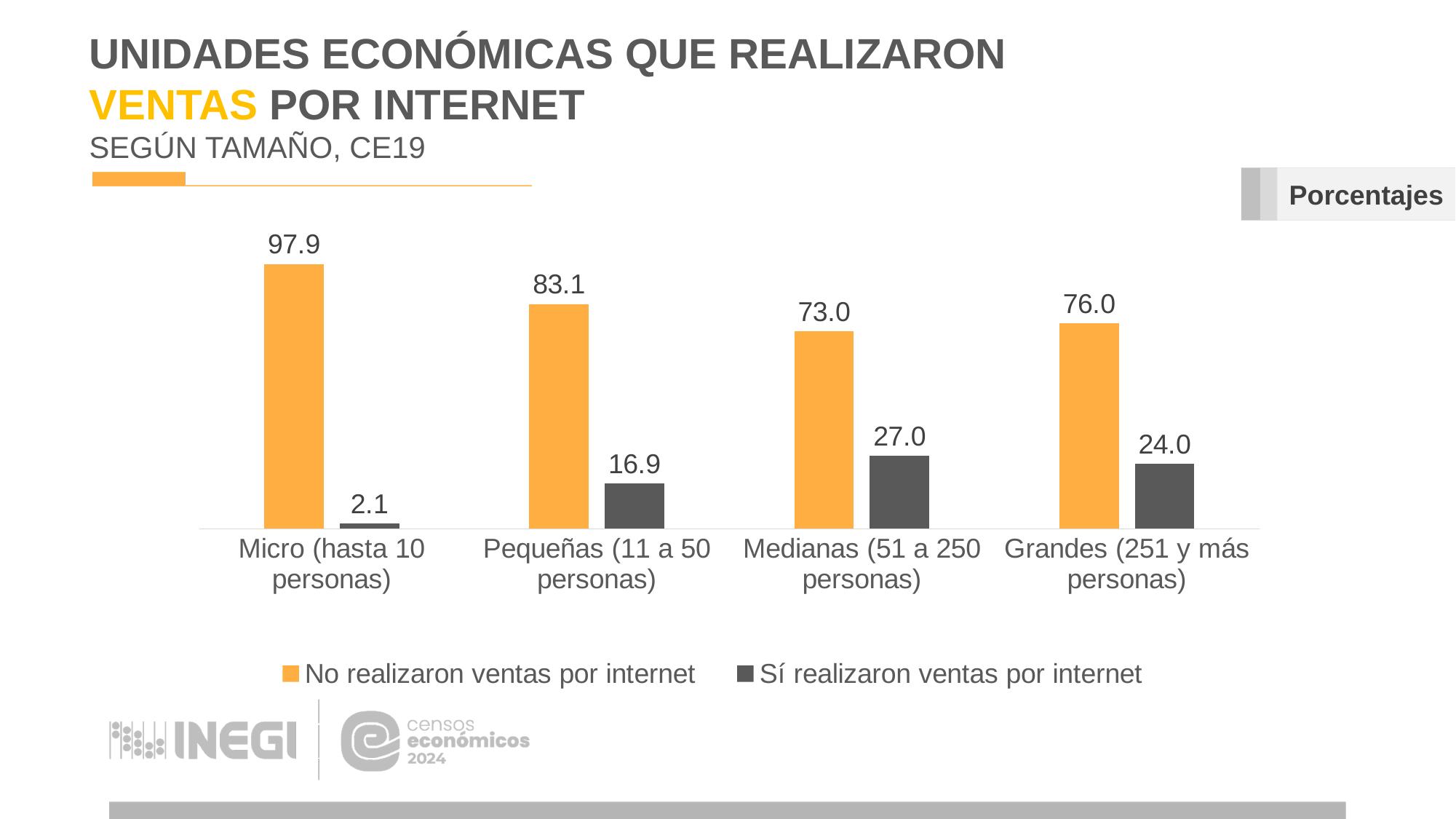
Which size category has the lowest value for 'No realizaron ventas por internet'? Medianas (51 a 250 personas) Which colour represents 'Sí realizaron ventas por internet' in the legend? Dark grey How many size categories are shown on the x axis? 4 What kind of chart is shown on the slide? Bar chart Which size category has the highest value for 'Sí realizaron ventas por internet'? Medianas (51 a 250 personas) What is the value for 'Sí realizaron ventas por internet' for Pequeñas (11 a 50 personas)? 16.9 What is the value for 'Sí realizaron ventas por internet' for Medianas (51 a 250 personas)? 27.0 Do the 'No realizaron ventas por internet' values rise or fall from Micro to Medianas along the x axis? Fall How many series does the legend list? 2 What is the difference between the 'No realizaron ventas por internet' values for Micro (hasta 10 personas) and Grandes (251 y más personas)? 21.9 Which is larger: the 'Sí realizaron ventas por internet' value for Grandes (251 y más personas) or for Pequeñas (11 a 50 personas)? Grandes (251 y más personas) What is the value for 'No realizaron ventas por internet' for Micro (hasta 10 personas)? 97.9